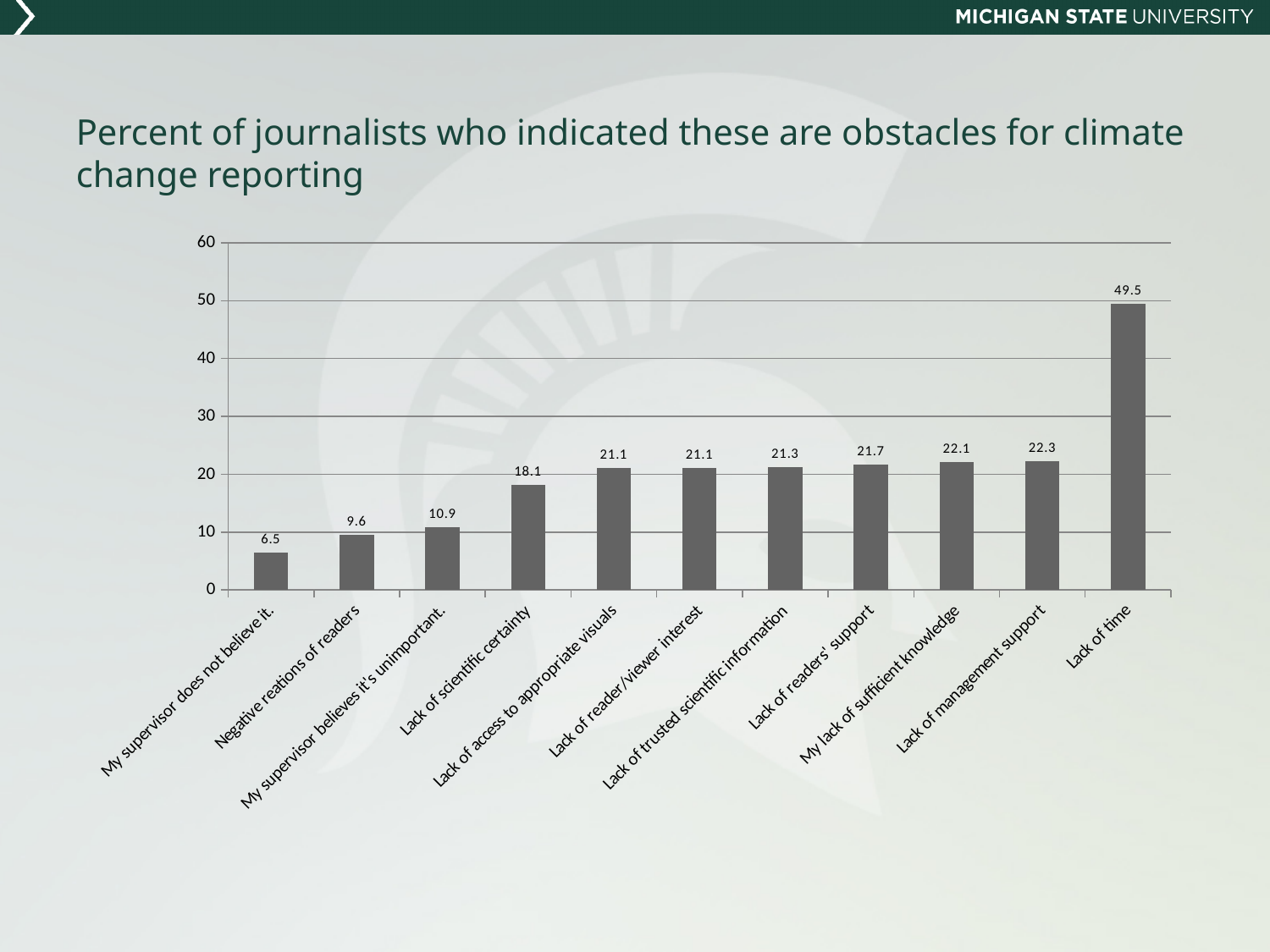
What is the value for "My supervisor does not believe it."? 6.5 Do the values rise or fall from left to right along the x axis? Rise Is the value for "Lack of readers' support" greater or less than 20? greater What is the difference between the values for "Lack of time" and "Lack of management support"? 27.2 What is the value for "Lack of time"? 49.5 How many categories are shown in the chart? 11 Which category has the lowest value? My supervisor does not believe it. What is the value for "Lack of scientific certainty"? 18.1 Which category has the highest value? Lack of time What is the value for "Lack of management support"? 22.3 What kind of chart is shown on the slide? Bar chart Which is larger, the value for "Negative reactions of readers" or the value for "My supervisor believes it's unimportant."? My supervisor believes it's unimportant.